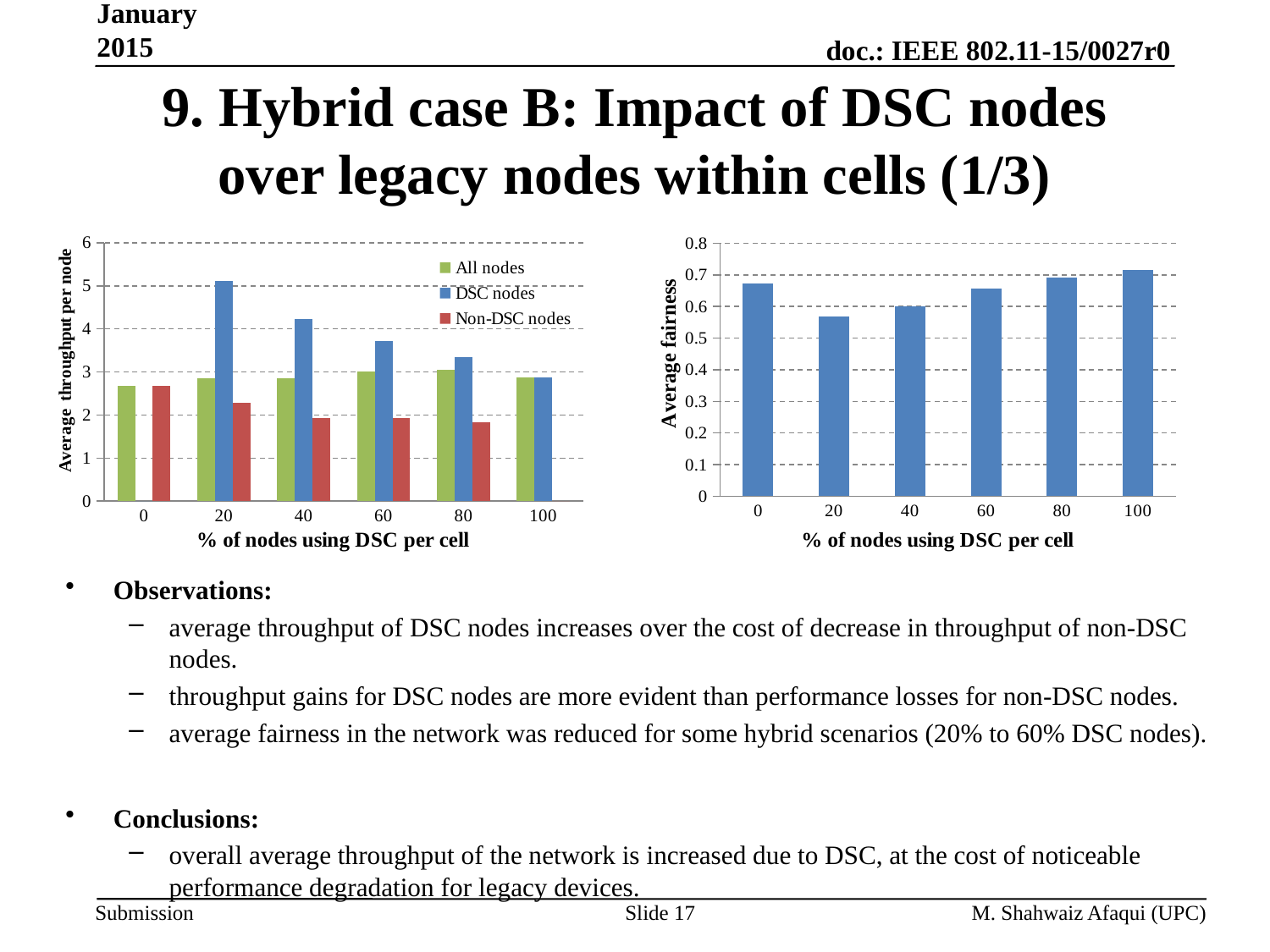
In the left chart (Average throughput per node), at which % of nodes using DSC per cell is the DSC nodes bar highest? 20 In the right chart (Average fairness), is the value at 20% greater or less than 0.6? less In the right chart (Average fairness), at which % of nodes using DSC per cell is the fairness lowest? 20 In the right chart (Average fairness), at which % of nodes using DSC per cell is the fairness highest? 100 In the left chart (Average throughput per node), what are the three legend entries? All nodes, DSC nodes, Non-DSC nodes In the left chart (Average throughput per node), how many series does the legend list? 3 In the left chart (Average throughput per node), do the DSC nodes values rise or fall from 20% to 100%? fall In the left chart (Average throughput per node), is the DSC nodes value at 20% greater or less than 5? greater In the right chart (Average fairness), how many categories are shown on the x axis? 6 In the left chart (Average throughput per node), is the Non-DSC nodes value at 80% greater or less than 2? less In the left chart (Average throughput per node), which is larger at 40%: DSC nodes or Non-DSC nodes? DSC nodes What kind of chart is the right chart (Average fairness)? bar chart